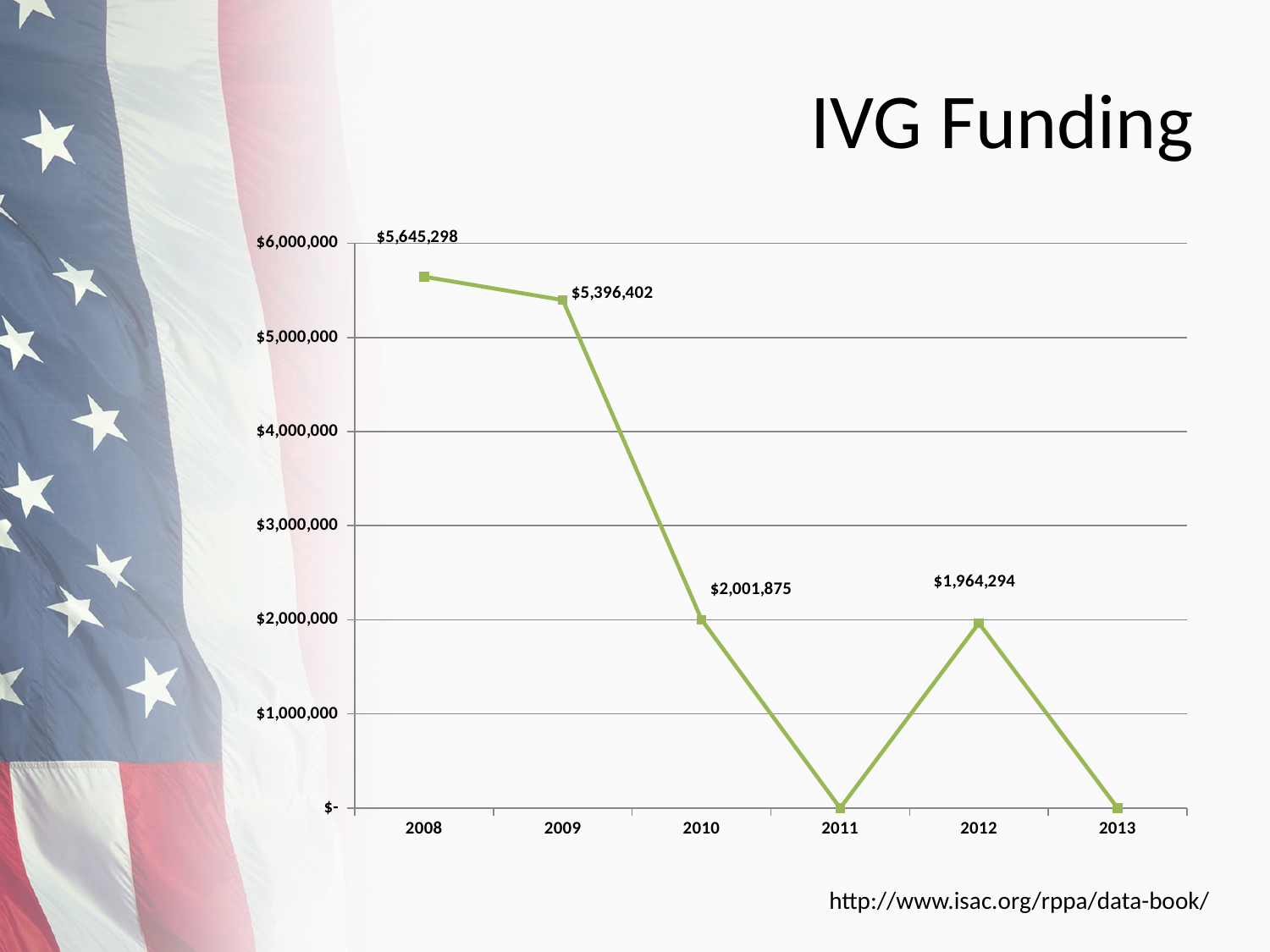
What is the title of the slide containing the chart? IVG Funding What is the difference between the 2008 and 2009 IVG funding values? $248,896 Which year had higher IVG funding, 2010 or 2012? 2010 What is the IVG funding value for 2012? $1,964,294 Does IVG funding generally rise or fall from 2008 to 2013? Fall What is the IVG funding value for 2010? $2,001,875 What type of chart is shown on the slide? Line chart In which year was IVG funding highest? 2008 How many years are plotted on the x axis of the chart? 6 Is the IVG funding value for 2009 greater or less than $5,000,000? greater What is the IVG funding value for 2008? $5,645,298 What is the IVG funding value for 2009? $5,396,402